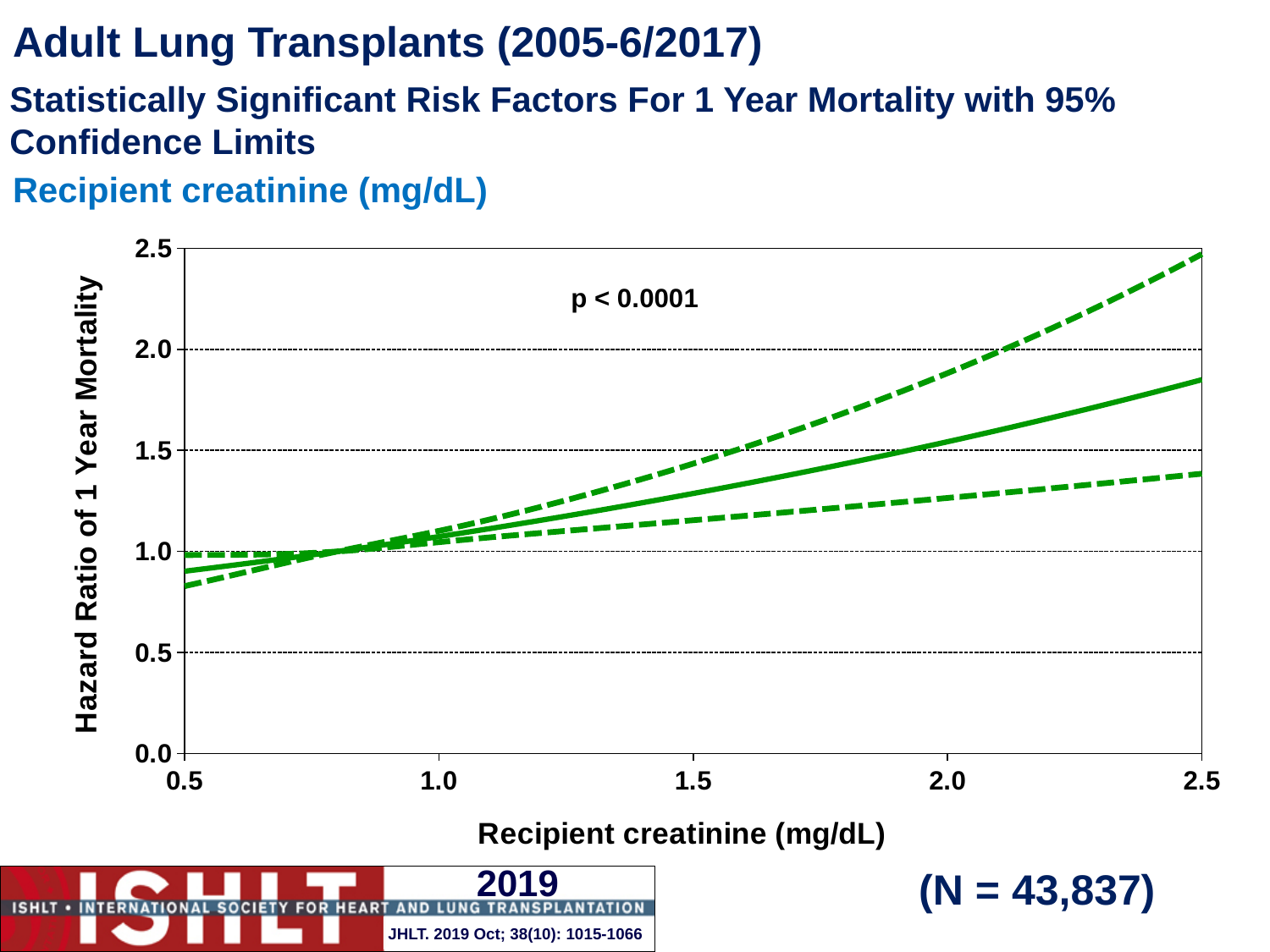
Is the hazard ratio (solid line) at a recipient creatinine of 1.5 mg/dL greater or less than 1.0? greater What is the label of the y axis of the chart? Hazard Ratio of 1 Year Mortality What is the highest value shown on the x axis of the chart? 2.5 What kind of chart is shown on the slide? line chart What p-value is printed on the chart? p < 0.0001 Is the hazard ratio (solid line) at a recipient creatinine of 0.5 mg/dL greater or less than 1.0? less Is the hazard ratio (solid line) at a recipient creatinine of 2.5 mg/dL greater or less than 1.5? greater What is the sample size (N) shown on the slide? 43,837 How many lines are plotted on the chart? 3 Does the hazard ratio of 1 year mortality rise or fall as recipient creatinine increases from 0.5 to 2.5 mg/dL? rise